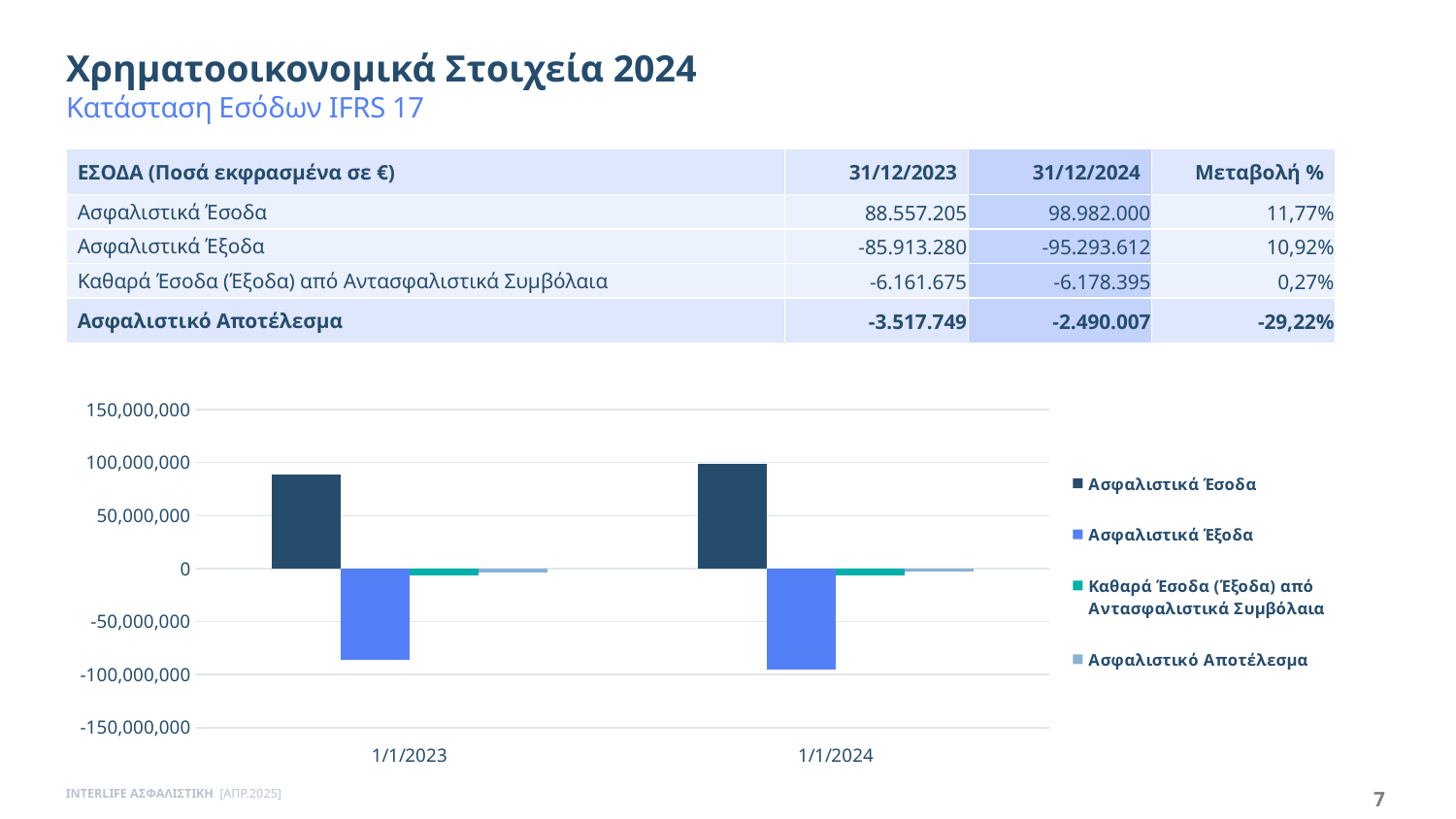
Which series in the chart is shown in dark navy? Ασφαλιστικά Έσοδα Which is larger, the Ασφαλιστικά Έσοδα bar for 1/1/2023 or for 1/1/2024? 1/1/2024 What kind of chart is shown on the slide? bar chart Is the value for Ασφαλιστικά Έξοδα at 1/1/2023 greater or less than -50,000,000? less Is the value for Ασφαλιστικά Έσοδα at 1/1/2024 greater or less than 50,000,000? greater Is the value for Ασφαλιστικά Έσοδα at 1/1/2023 greater or less than 50,000,000? greater Does the Ασφαλιστικά Έσοδα series rise or fall from 1/1/2023 to 1/1/2024? rise What are the two labels on the x axis of the chart? 1/1/2023 and 1/1/2024 How many series does the chart legend list? 4 How many categories are shown on the x axis of the chart? 2